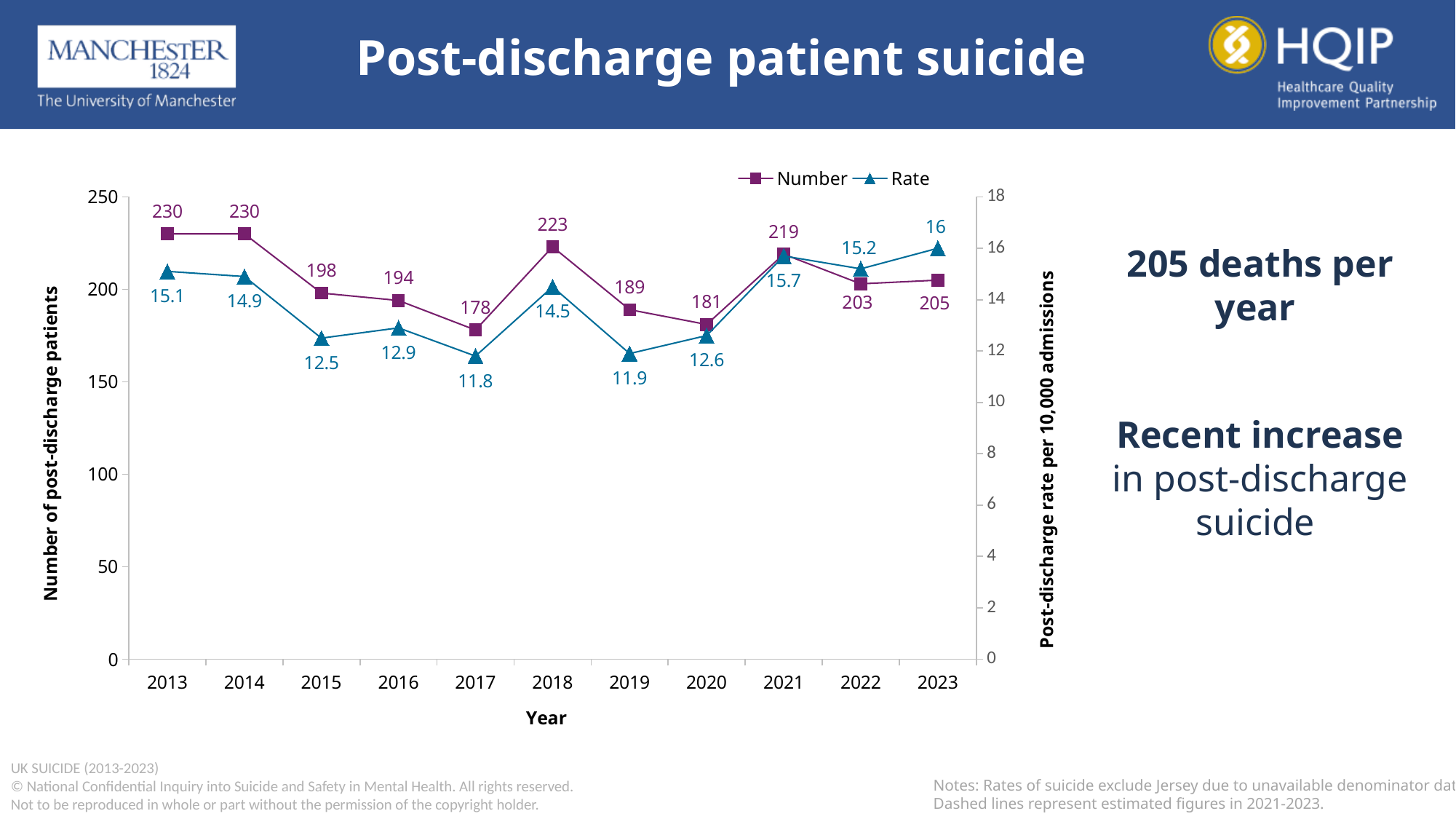
Which year has the highest Rate per 10,000 admissions? 2023 How many series does the legend list? 2 What kind of chart is shown on the slide? Line chart Is the Number of post-discharge patients larger in 2021 or in 2022? 2021 Is the Rate in 2019 greater or less than 12? less How many years are shown on the x axis? 11 What is the Number of post-discharge patients in 2018? 223 What is the Number of post-discharge patients in 2023? 205 Which year has the lowest Number of post-discharge patients? 2017 What is the label of the right-hand vertical axis? Post-discharge rate per 10,000 admissions What is the Rate per 10,000 admissions in 2017? 11.8 What is the difference in Number of post-discharge patients between 2013 and 2017? 52